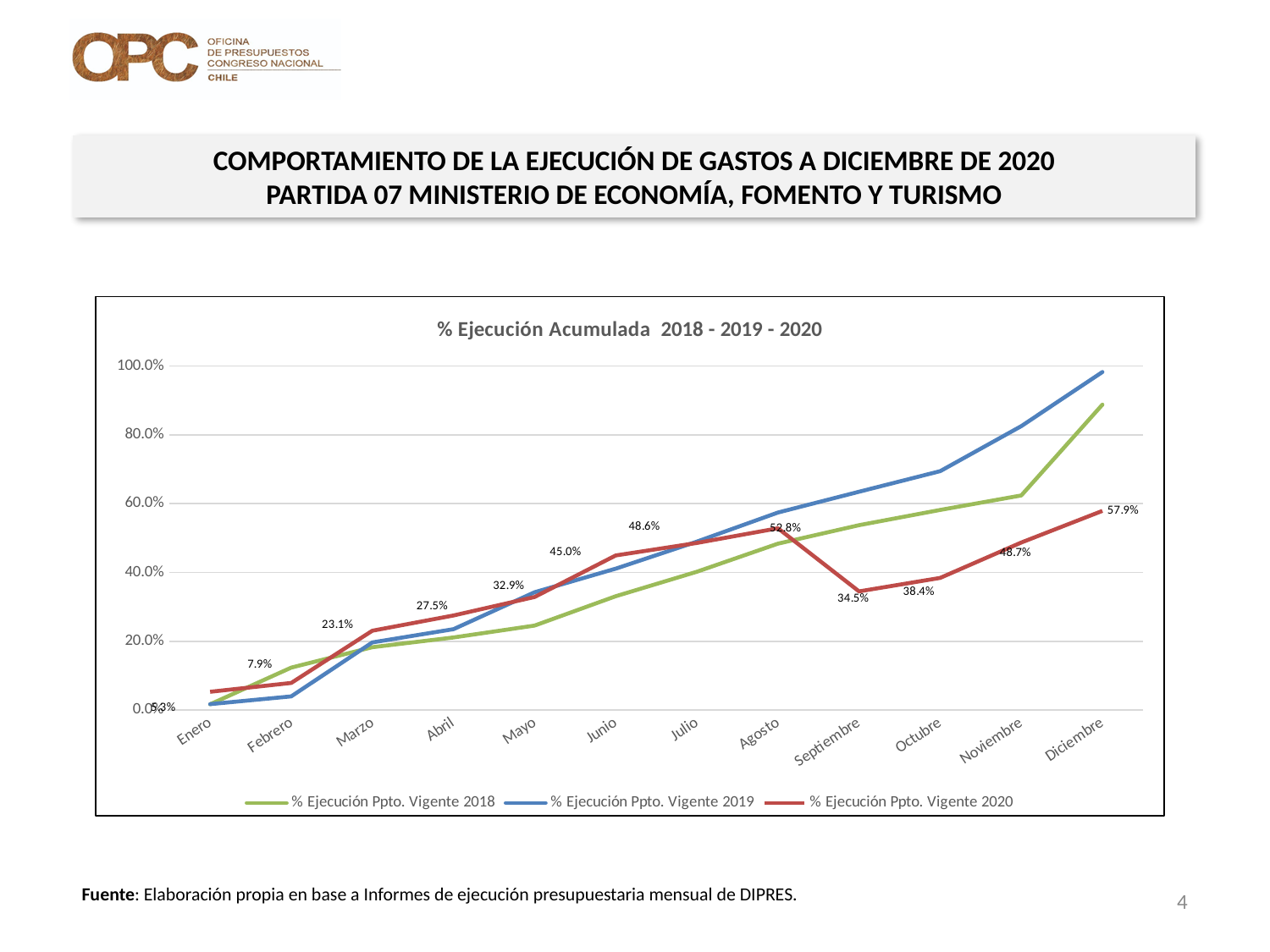
How many series does the legend list? 3 Which is larger in Octubre, % Ejecución Ppto. Vigente 2018 or % Ejecución Ppto. Vigente 2020? % Ejecución Ppto. Vigente 2018 What is the value for % Ejecución Ppto. Vigente 2020 in Marzo? 23.1% What is the difference between the % Ejecución Ppto. Vigente 2020 values for Agosto and Septiembre? 18.3% How many months are shown on the x axis? 12 What is the value for % Ejecución Ppto. Vigente 2020 in Septiembre? 34.5% What is the value for % Ejecución Ppto. Vigente 2020 in Diciembre? 57.9% What type of chart is shown on the slide? line chart What is the title of the chart? % Ejecución Acumulada 2018 - 2019 - 2020 What is the value for % Ejecución Ppto. Vigente 2020 in Agosto? 52.8% Is the value for % Ejecución Ppto. Vigente 2019 in Diciembre greater or less than 80.0%? greater Which series has the highest value in Diciembre? % Ejecución Ppto. Vigente 2019